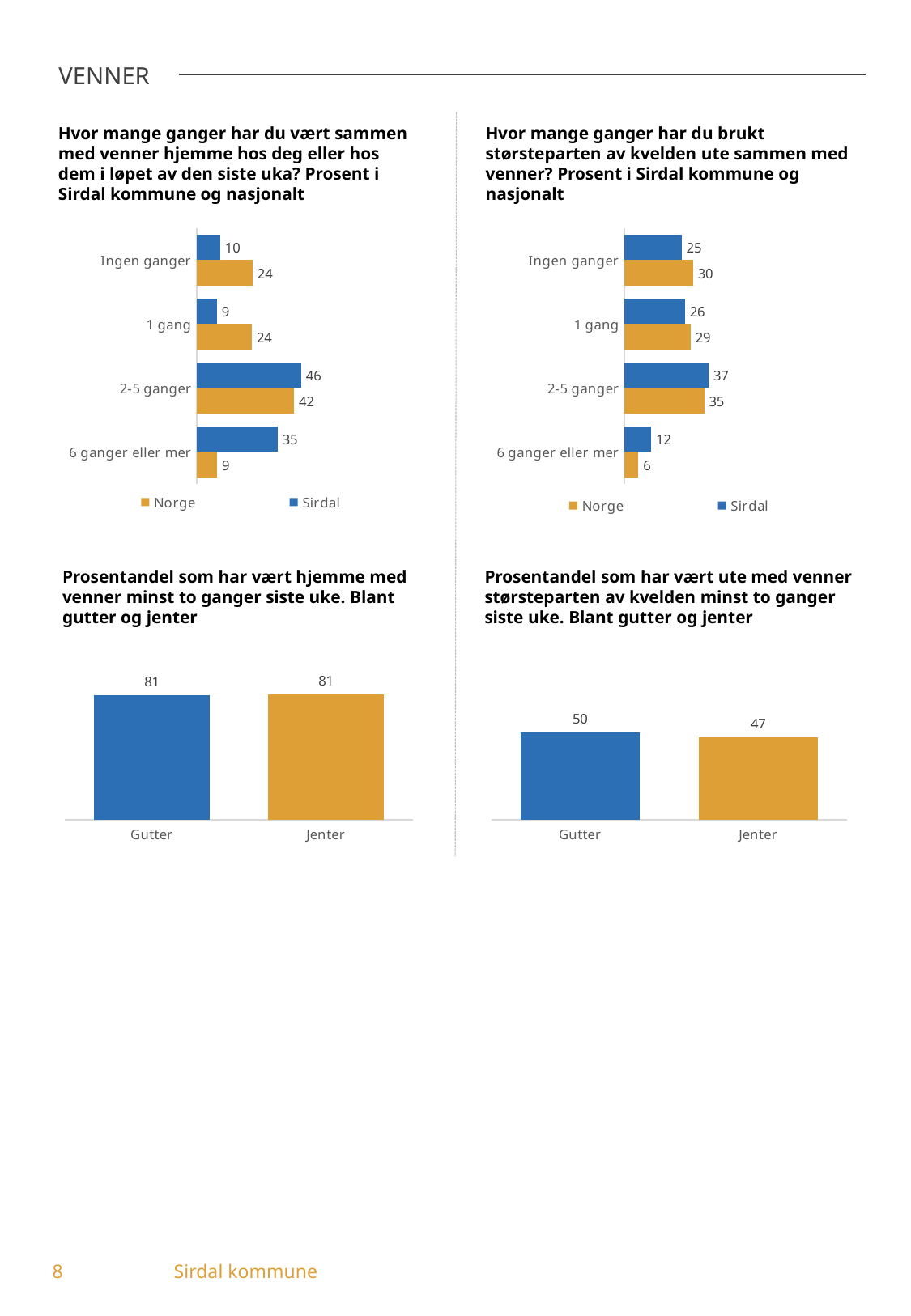
In the top-right chart (evening out with friends), which is larger in the 'Ingen ganger' category, Sirdal or Norge? Norge In the bottom-right chart (out with friends at least twice, boys and girls), what is the difference between Gutter and Jenter? 3 In the top-right chart (evening out with friends), which category has the lowest value for Norge? 6 ganger eller mer In the top-left chart (friends at home in the last week), what is the difference between Sirdal and Norge in the '6 ganger eller mer' category? 26 In the top-left chart (friends at home in the last week), which category has the highest value for Sirdal? 2-5 ganger In the top-left chart (friends at home in the last week), what is the value for Sirdal in the '6 ganger eller mer' category? 35 In the top-left chart (friends at home in the last week), what is the value for Norge in the 'Ingen ganger' category? 24 What type of chart is the bottom-right chart (out with friends at least twice, boys and girls)? Bar chart How many categories are shown in the top-left chart (friends at home in the last week)? 4 How many series does the legend list in the top-right chart (evening out with friends)? 2 In the bottom-left chart (at home with friends at least twice, boys and girls), what is the value for Jenter? 81 In the top-right chart (evening out with friends), what is the value for Norge in the '2-5 ganger' category? 35